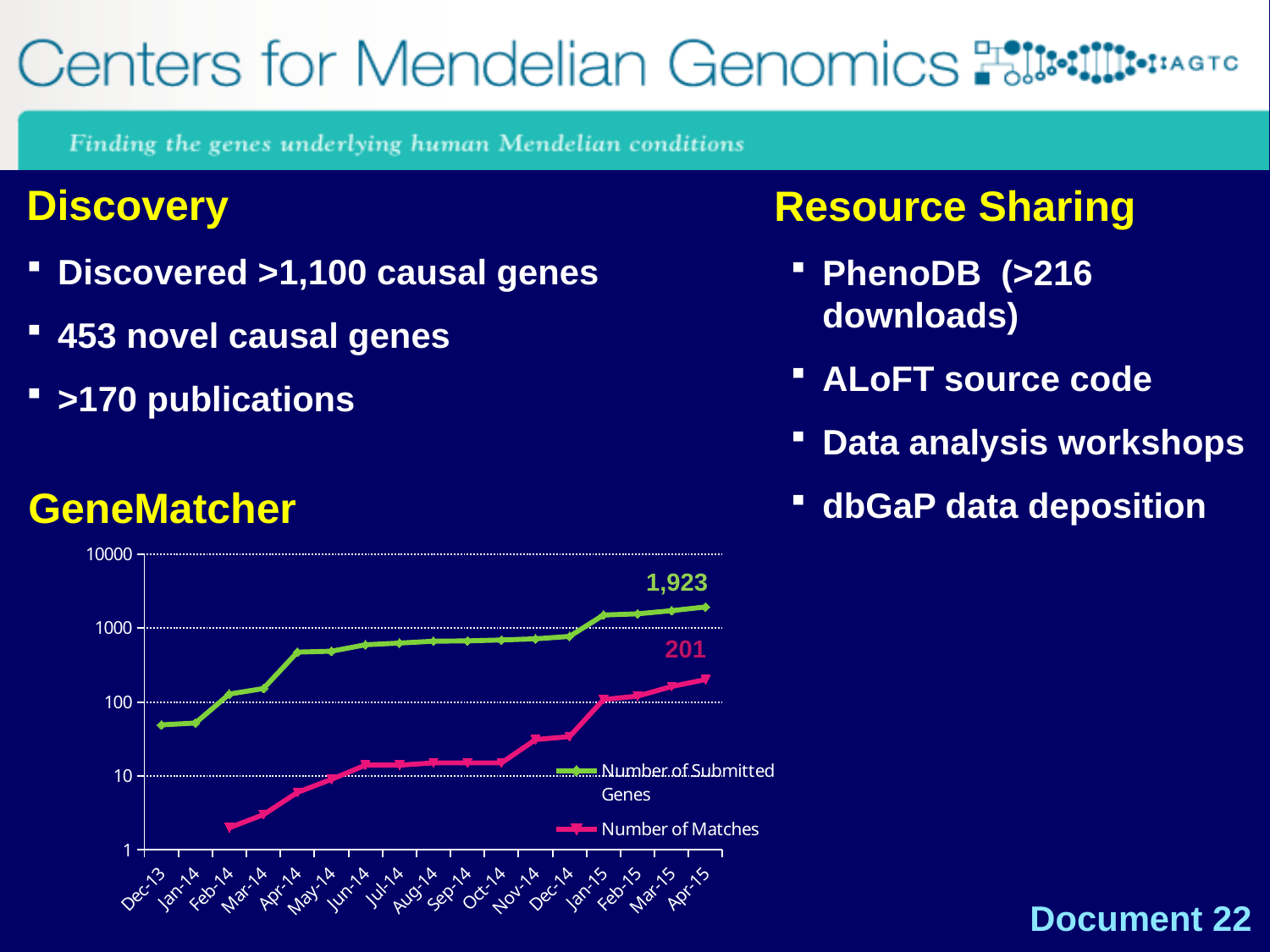
In the GeneMatcher chart, what is the difference between the Number of Submitted Genes and the Number of Matches at Apr-15? 1,722 In the GeneMatcher chart, what is the Number of Submitted Genes at Apr-15? 1,923 In the GeneMatcher chart, is the Number of Submitted Genes at Dec-13 greater or less than 100? less What kind of chart is shown under the GeneMatcher heading? line chart In the GeneMatcher chart, is the Number of Matches at Nov-14 greater or less than 100? less In the GeneMatcher chart, which series has the larger value at Apr-15, Number of Submitted Genes or Number of Matches? Number of Submitted Genes How many series does the legend of the GeneMatcher chart list? 2 How many months are shown on the x axis of the GeneMatcher chart? 17 In the GeneMatcher chart, what is the Number of Matches at Apr-15? 201 In the GeneMatcher chart, is the Number of Submitted Genes at Apr-14 greater or less than 100? greater In the GeneMatcher chart, which colour is used for the Number of Matches series? pink In the GeneMatcher chart, do the values of the Number of Submitted Genes series rise or fall from Dec-13 to Apr-15? rise